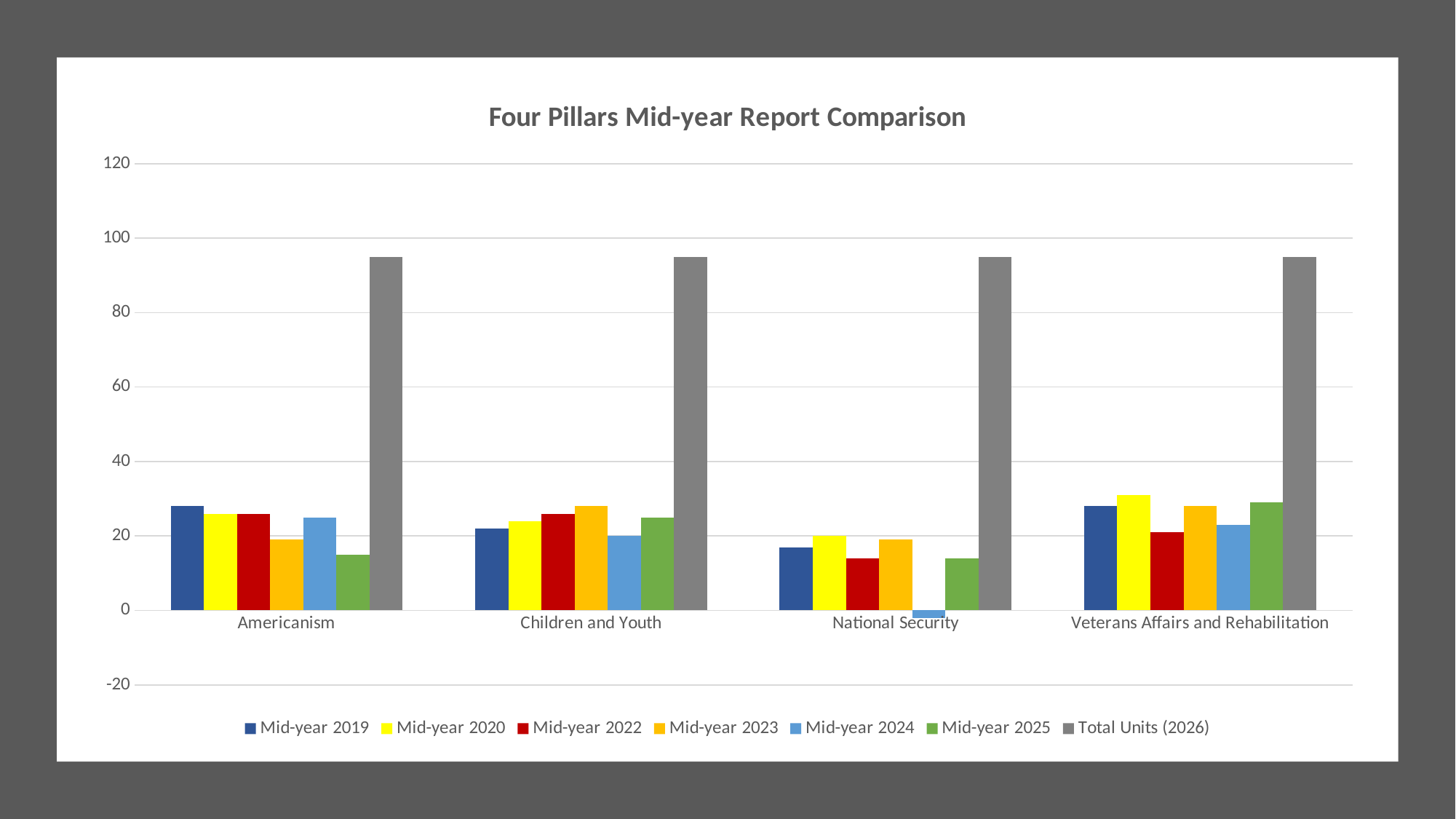
Is the Mid-year 2024 value for National Security greater or less than 0? less How many categories are shown on the x axis of the chart? 4 Which category has the highest Mid-year 2020 value? Veterans Affairs and Rehabilitation Which category has the lowest Mid-year 2024 value? National Security Is the Mid-year 2020 value for Veterans Affairs and Rehabilitation greater or less than 20? greater For Americanism, which is larger, the Mid-year 2023 value or the Mid-year 2025 value? Mid-year 2023 What kind of chart is shown on the slide? Bar chart Is the Total Units (2026) value for Americanism greater or less than 80? greater Which is larger, the Mid-year 2019 value for Americanism or the Mid-year 2019 value for National Security? Americanism How many series does the legend list? 7 What is the title of the chart? Four Pillars Mid-year Report Comparison